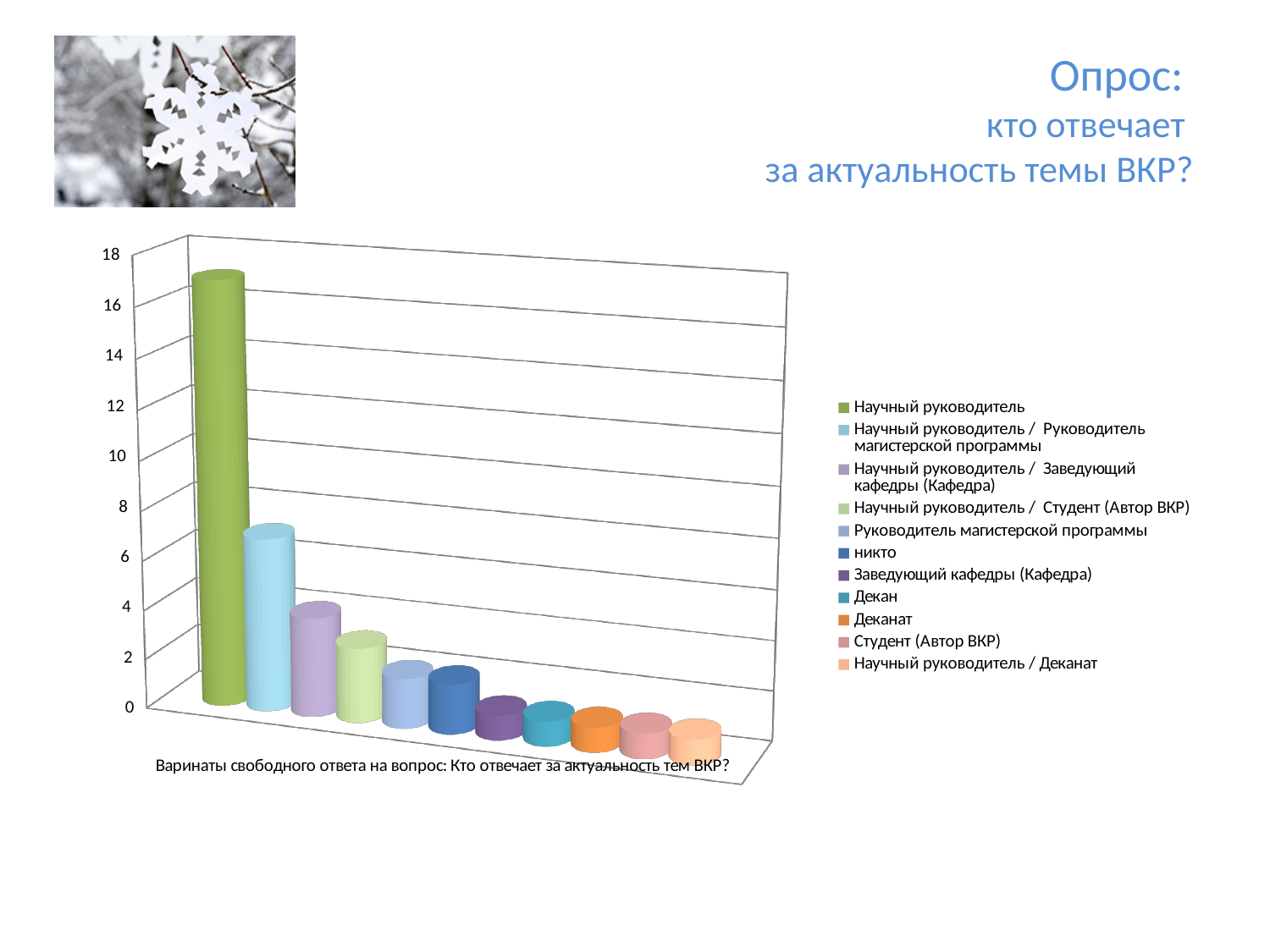
What is the highest value shown on the vertical axis? 18 Is the value for Научный руководитель / Руководитель магистерской программы greater or less than 4? greater Which series has the highest bar? Научный руководитель How many series does the legend list? 11 Is the value for Научный руководитель greater or less than 14? greater Is the value for Декан greater or less than 4? less How many categories are shown on the horizontal axis? 1 What is the label shown under the bars on the horizontal axis? Варинаты свободного ответа на вопрос: Кто отвечает за актуальность тем ВКР? What kind of chart is shown on the slide? bar chart Which is larger: the value for Научный руководитель / Руководитель магистерской программы or the value for Научный руководитель / Заведующий кафедры (Кафедра)? Научный руководитель / Руководитель магистерской программы Which is larger: the value for Научный руководитель or the value for Декан? Научный руководитель